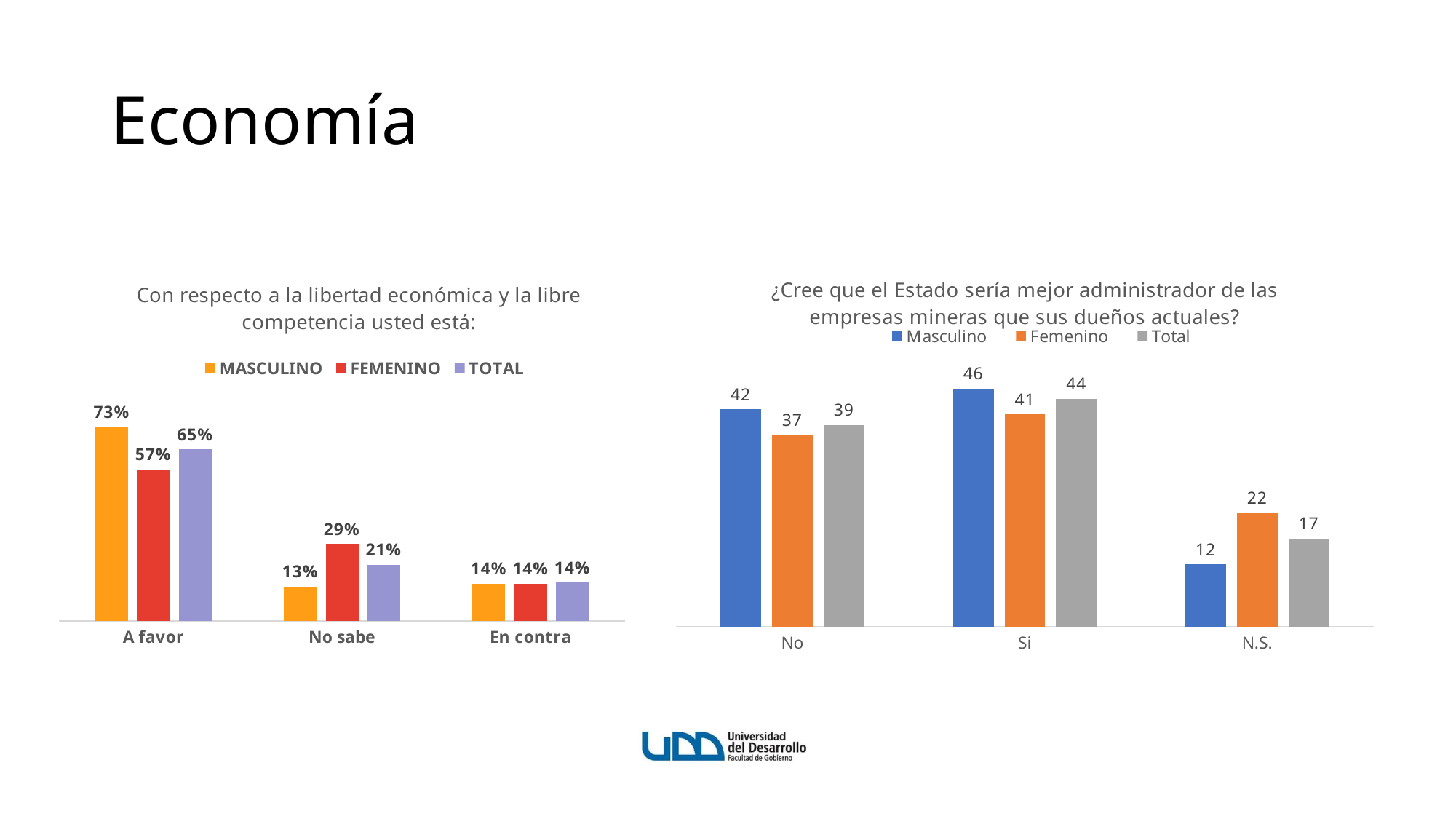
In the right chart (Estado administrador de empresas mineras), which is larger for No: Masculino or Femenino? Masculino In the left chart (libertad económica), what is the TOTAL value for En contra? 14% In the left chart (libertad económica), what is the FEMENINO value for No sabe? 29% In the left chart (libertad económica), which category has the highest TOTAL value? A favor In the left chart (libertad económica), how many series does the legend list? 3 In the left chart (libertad económica), what is the MASCULINO value for A favor? 73% In the right chart (Estado administrador de empresas mineras), what is the difference between the Femenino and Masculino values for N.S.? 10 In the right chart (Estado administrador de empresas mineras), what is the Femenino value for N.S.? 22 What kind of chart is the right chart (Estado administrador de empresas mineras)? Bar chart In the right chart (Estado administrador de empresas mineras), what is the Masculino value for Si? 46 In the right chart (Estado administrador de empresas mineras), which category has the lowest Total value? N.S. In the left chart (libertad económica), what is the difference between the MASCULINO and FEMENINO values for A favor? 16%